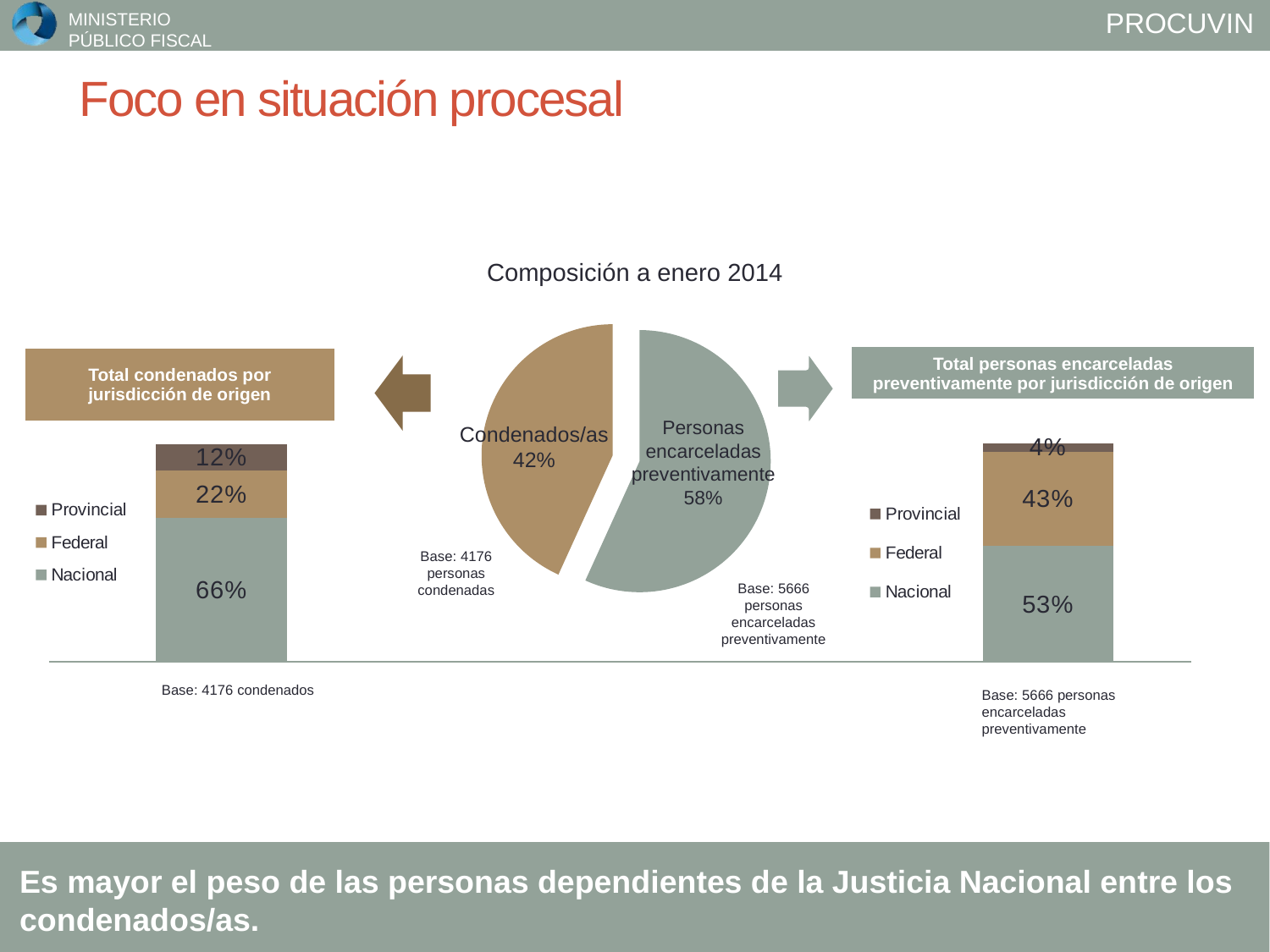
In the left chart 'Total condenados por jurisdicción de origen', what is the value for Provincial? 12% What kind of chart is the left chart 'Total condenados por jurisdicción de origen'? Stacked bar chart In the left chart 'Total condenados por jurisdicción de origen', what is the difference between Nacional and Federal? 44% In the left chart 'Total condenados por jurisdicción de origen', which jurisdiction has the lowest value? Provincial In the right chart 'Total personas encarceladas preventivamente por jurisdicción de origen', which jurisdiction has the highest value? Nacional In the left chart 'Total condenados por jurisdicción de origen', what is the value for Nacional? 66% In the pie chart 'Composición a enero 2014', how many slices are there? 2 In the pie chart 'Composición a enero 2014', what share is labelled for Personas encarceladas preventivamente? 58% In the pie chart 'Composición a enero 2014', which slice is larger, Condenados/as or Personas encarceladas preventivamente? Personas encarceladas preventivamente In the right chart 'Total personas encarceladas preventivamente por jurisdicción de origen', how many series does the legend list? 3 In the pie chart 'Composición a enero 2014', what share is labelled for Condenados/as? 42% In the right chart 'Total personas encarceladas preventivamente por jurisdicción de origen', what is the value for Federal? 43%